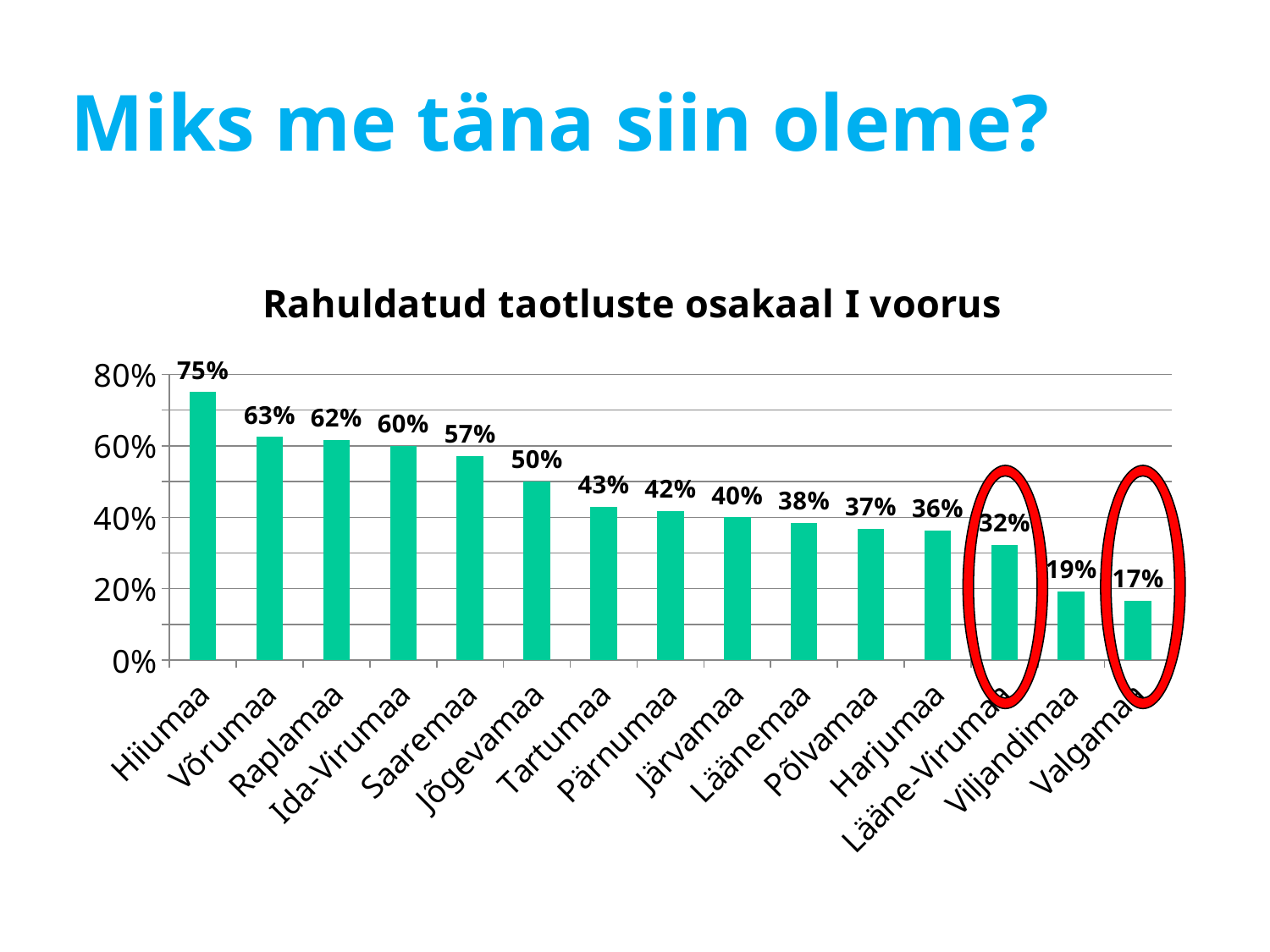
What is the difference between the values for Hiiumaa and Valgamaa? 58% Which category has the lowest value? Valgamaa Which category has the highest value? Hiiumaa What is the value for Tartumaa? 43% What is the value for Lääne-Virumaa? 32% How many categories are shown on the x axis? 15 What kind of chart is this? Bar chart What is the difference between the values for Võrumaa and Saaremaa? 6% Which has a larger value, Jõgevamaa or Põlvamaa? Jõgevamaa What is the value for Hiiumaa? 75% What is the title of the chart? Rahuldatud taotluste osakaal I voorus Do the values rise or fall from left to right along the x axis? Fall